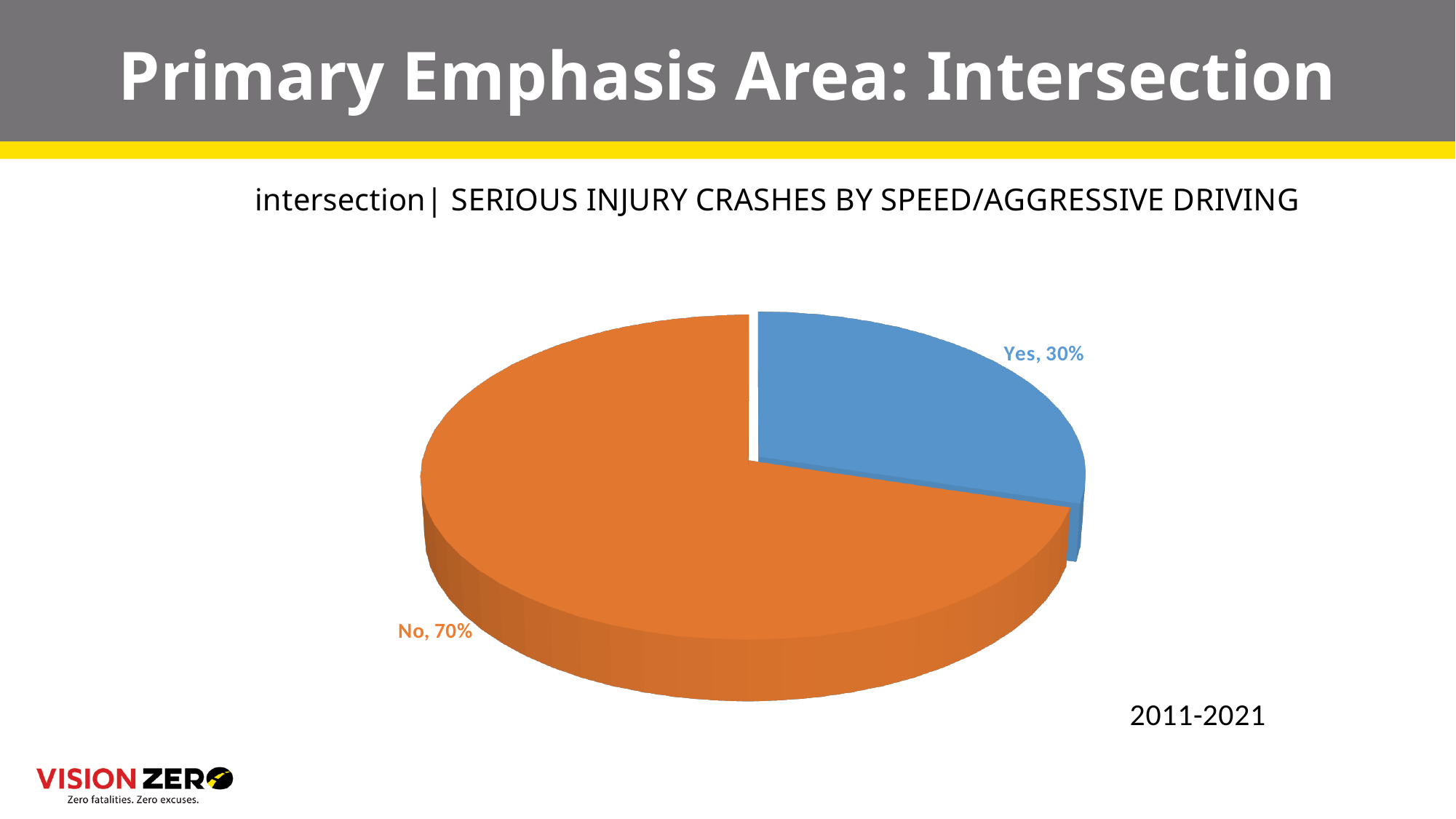
How many slices does the pie chart have? 2 What is the difference in percentage points between the No and Yes slices? 40 What colour is the Yes slice of the pie chart? Blue What is the title of the chart? intersection| SERIOUS INJURY CRASHES BY SPEED/AGGRESSIVE DRIVING Which is larger, the Yes slice or the No slice? No Which slice of the pie chart is the smallest? Yes What share of serious injury crashes at intersections did not involve speed/aggressive driving (No)? 70% Which slice of the pie chart is the largest? No What kind of chart is shown on the slide? Pie chart What time period does the chart cover, as noted on the slide? 2011-2021 What share of serious injury crashes at intersections involved speed/aggressive driving (Yes)? 30%